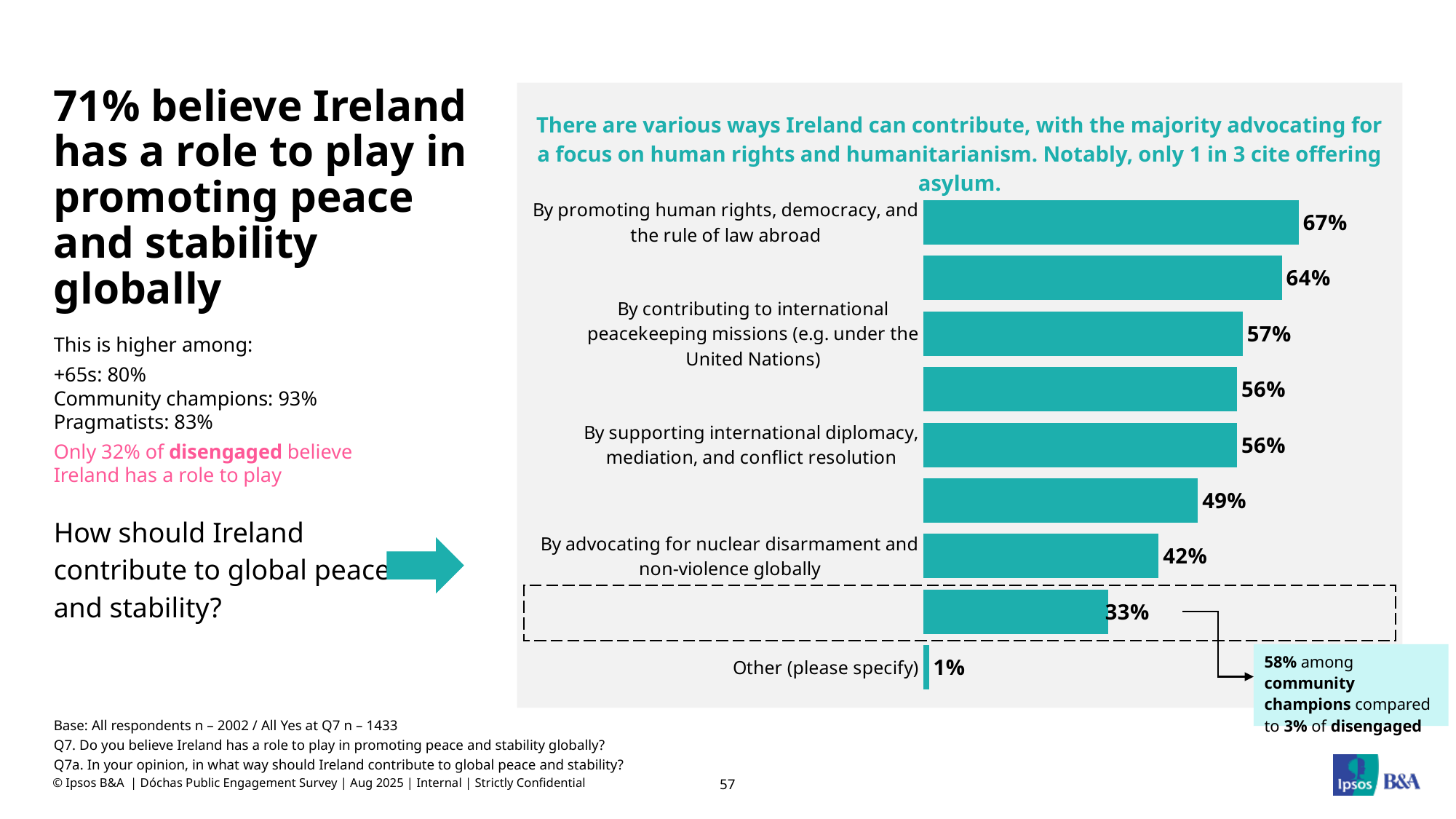
What percentage of respondents chose 'By promoting human rights, democracy, and the rule of law abroad'? 67% What is the value of the bar highlighted with a dashed box? 33% What type of chart is shown on the slide? Bar chart How many bars are plotted in the chart? 9 What value is shown for 'By contributing to international peacekeeping missions (e.g. under the United Nations)'? 57% What is the difference between the value for 'By promoting human rights, democracy, and the rule of law abroad' and the value for 'By advocating for nuclear disarmament and non-violence globally'? 25 percentage points Which category has the highest value in the chart? By promoting human rights, democracy, and the rule of law abroad What value is shown for 'By advocating for nuclear disarmament and non-violence globally'? 42% Which is larger: the value for 'By contributing to international peacekeeping missions (e.g. under the United Nations)' or the value for 'By advocating for nuclear disarmament and non-violence globally'? By contributing to international peacekeeping missions (e.g. under the United Nations) What percentage is shown for 'Other (please specify)'? 1% What percentage is shown for 'By supporting international diplomacy, mediation, and conflict resolution'? 56% Which category has the lowest value in the chart? Other (please specify)